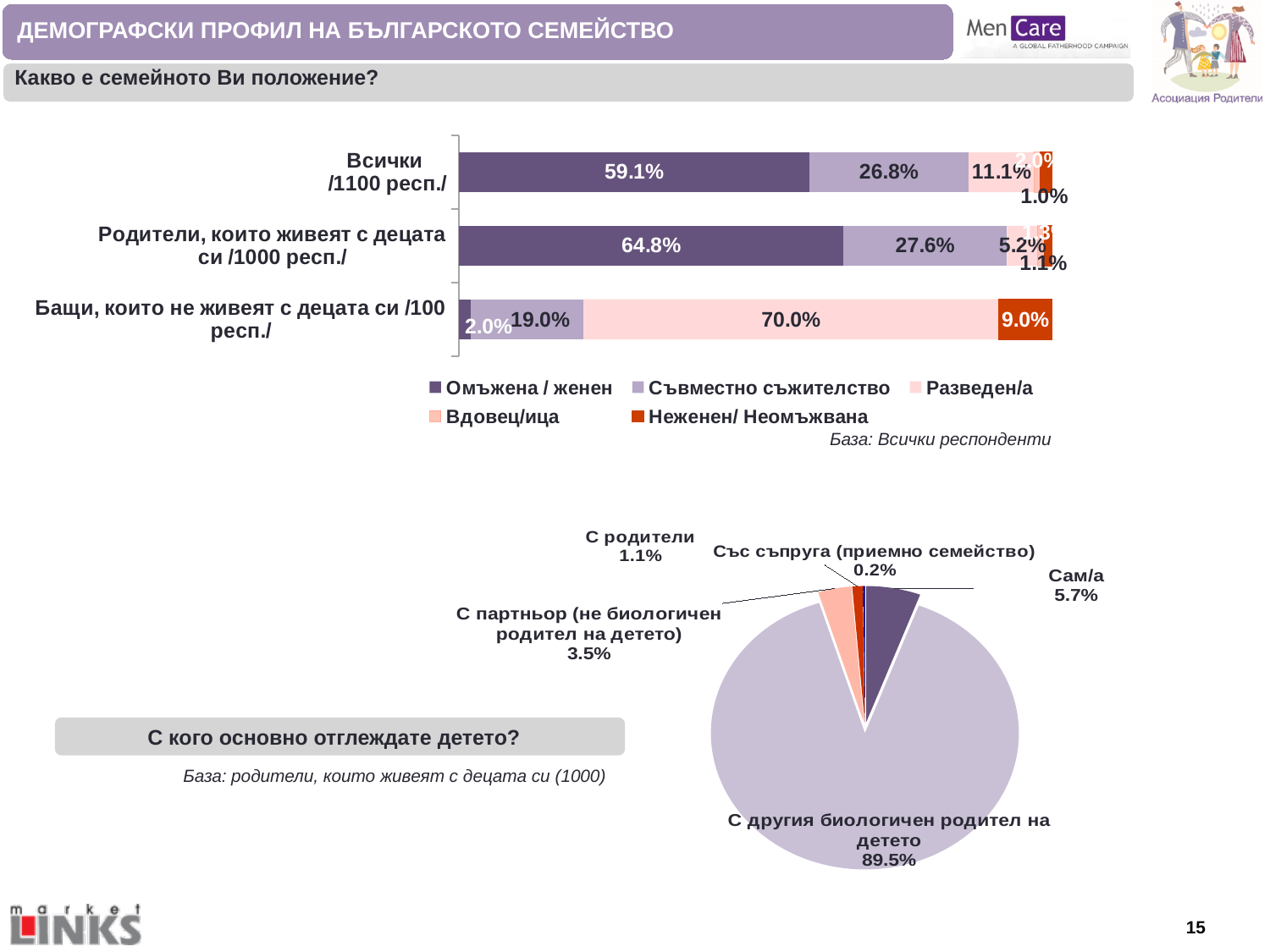
In the bar chart 'Какво е семейното Ви положение?', what is the value for 'Неженен/ Неомъжвана' for 'Бащи, които не живеят с децата си /100 респ./'? 9.0% In the bar chart 'Какво е семейното Ви положение?', what is the value for 'Разведен/а' for 'Бащи, които не живеят с децата си /100 респ./'? 70.0% What kind of chart is the chart under 'Какво е семейното Ви положение?'? Stacked bar chart In the bar chart 'Какво е семейното Ви положение?', which category has the highest value for 'Омъжена / женен'? Родители, които живеят с децата си /1000 респ./ In the bar chart 'Какво е семейното Ви положение?', what is the value for 'Съвместно съжителство' for 'Родители, които живеят с децата си /1000 респ./'? 27.6% In the bar chart 'Какво е семейното Ви положение?', what is the difference between the 'Разведен/а' values for 'Всички /1100 респ./' and 'Родители, които живеят с децата си /1000 респ./'? 5.9% In the pie chart 'С кого основно отглеждате детето?', which is larger: 'Сам/а' or 'С партньор (не биологичен родител на детето)'? Сам/а In the pie chart 'С кого основно отглеждате детето?', what is the share for 'С другия биологичен родител на детето'? 89.5% In the bar chart 'Какво е семейното Ви положение?', how many categories are shown? 3 In the pie chart 'С кого основно отглеждате детето?', which slice is the smallest? Със съпруга (приемно семейство) In the bar chart 'Какво е семейното Ви положение?', how many series does the legend list? 5 In the bar chart 'Какво е семейното Ви положение?', what is the value for 'Омъжена / женен' in the 'Всички /1100 респ./' category? 59.1%